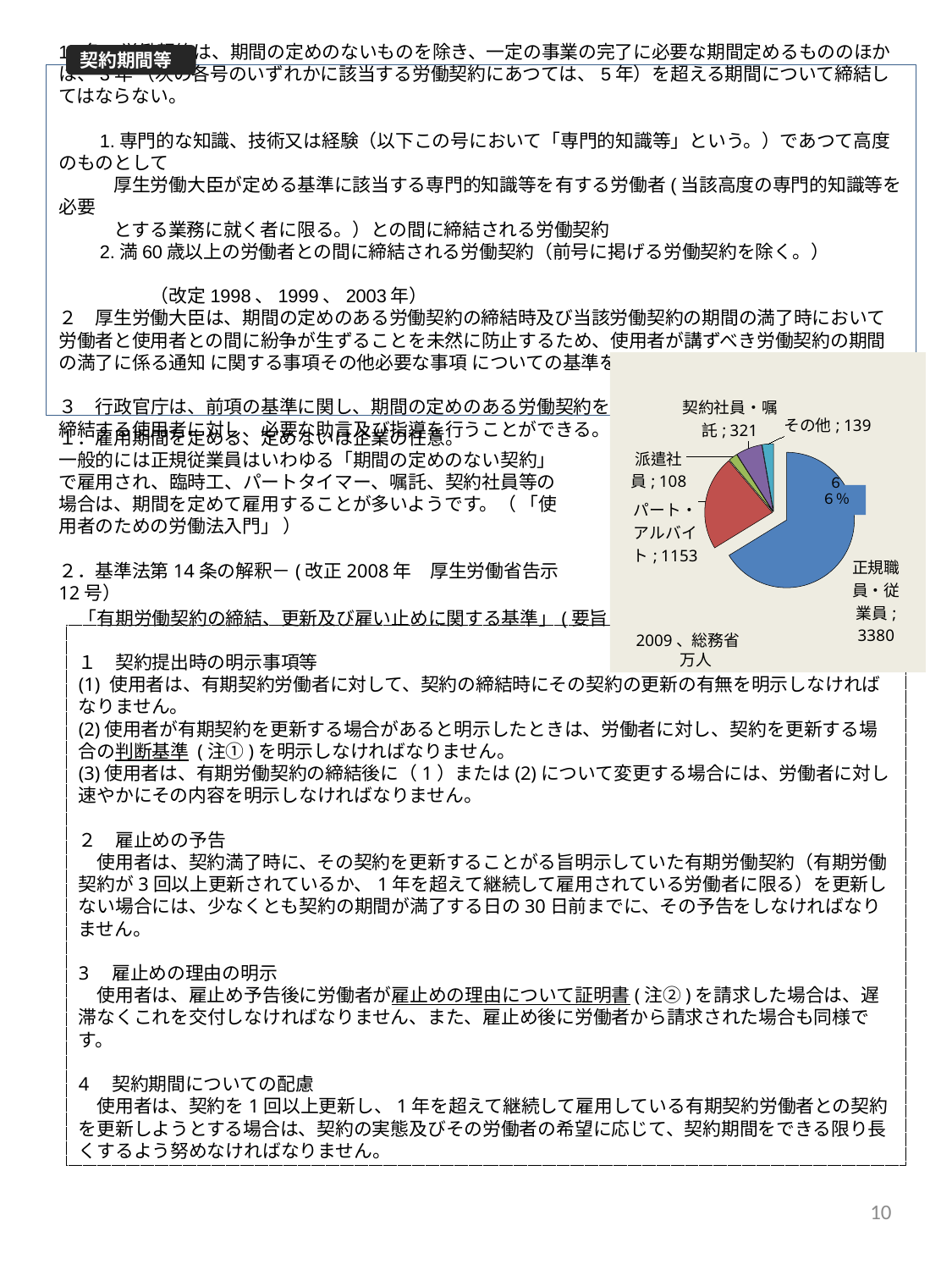
How many categories does the pie chart show? 5 What is the difference between the values for 正規職員・従業員 and パート・アルバイト? 2227 What percentage share is printed on the 正規職員・従業員 slice? 66% What is the value for 正規職員・従業員 in the pie chart? 3380 What is the value for その他 in the pie chart? 139 Which is larger in the pie chart, 契約社員・嘱託 or その他? 契約社員・嘱託 What type of chart is shown on the slide? pie chart What is the value for パート・アルバイト in the pie chart? 1153 Which category has the largest slice in the pie chart? 正規職員・従業員 What is the value for 派遣社員 in the pie chart? 108 What is the value for 契約社員・嘱託 in the pie chart? 321 Which category has the smallest slice in the pie chart? 派遣社員